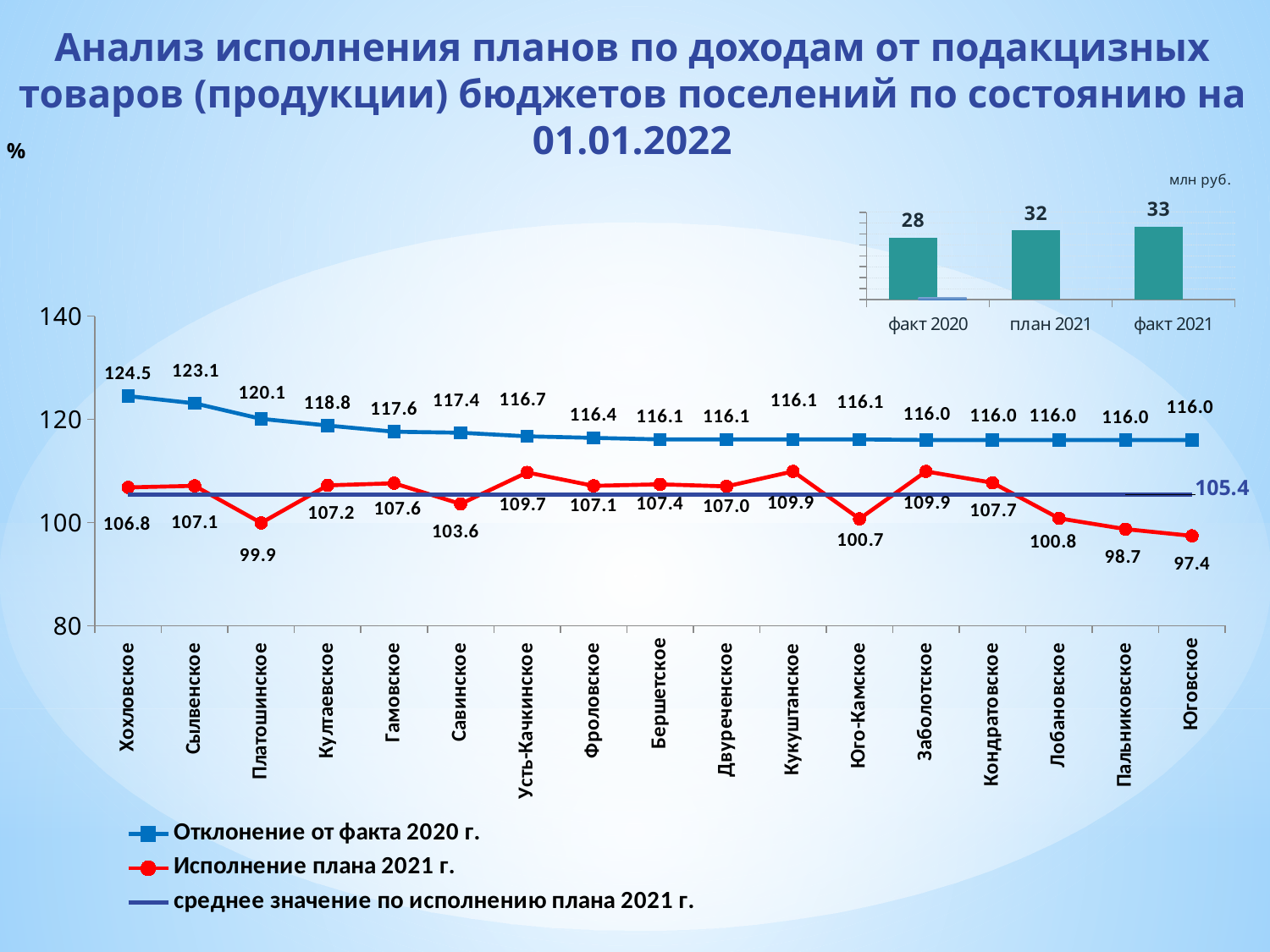
On the main line chart, which category has the lowest value of Исполнение плана 2021 г.? Юговское On the main line chart, does the Отклонение от факта 2020 г. series rise or fall from Хохловское to Юговское? fall On the small bar chart in the top right, what is the value for факт 2020? 28 On the small bar chart in the top right, what is the value for факт 2021? 33 On the main line chart, what is the value of Отклонение от факта 2020 г. for Хохловское? 124.5 On the small bar chart in the top right, what is the difference between план 2021 and факт 2020? 4 On the main line chart, how many series does the legend list? 3 On the small bar chart in the top right, how many bars are shown? 3 On the main line chart, what is the value of Исполнение плана 2021 г. for Платошинское? 99.9 On the main line chart, which category has the highest value of Отклонение от факта 2020 г.? Хохловское On the main line chart, how many categories are shown on the x axis? 17 On the main line chart, what is the difference between Отклонение от факта 2020 г. and Исполнение плана 2021 г. for Савинское? 13.8